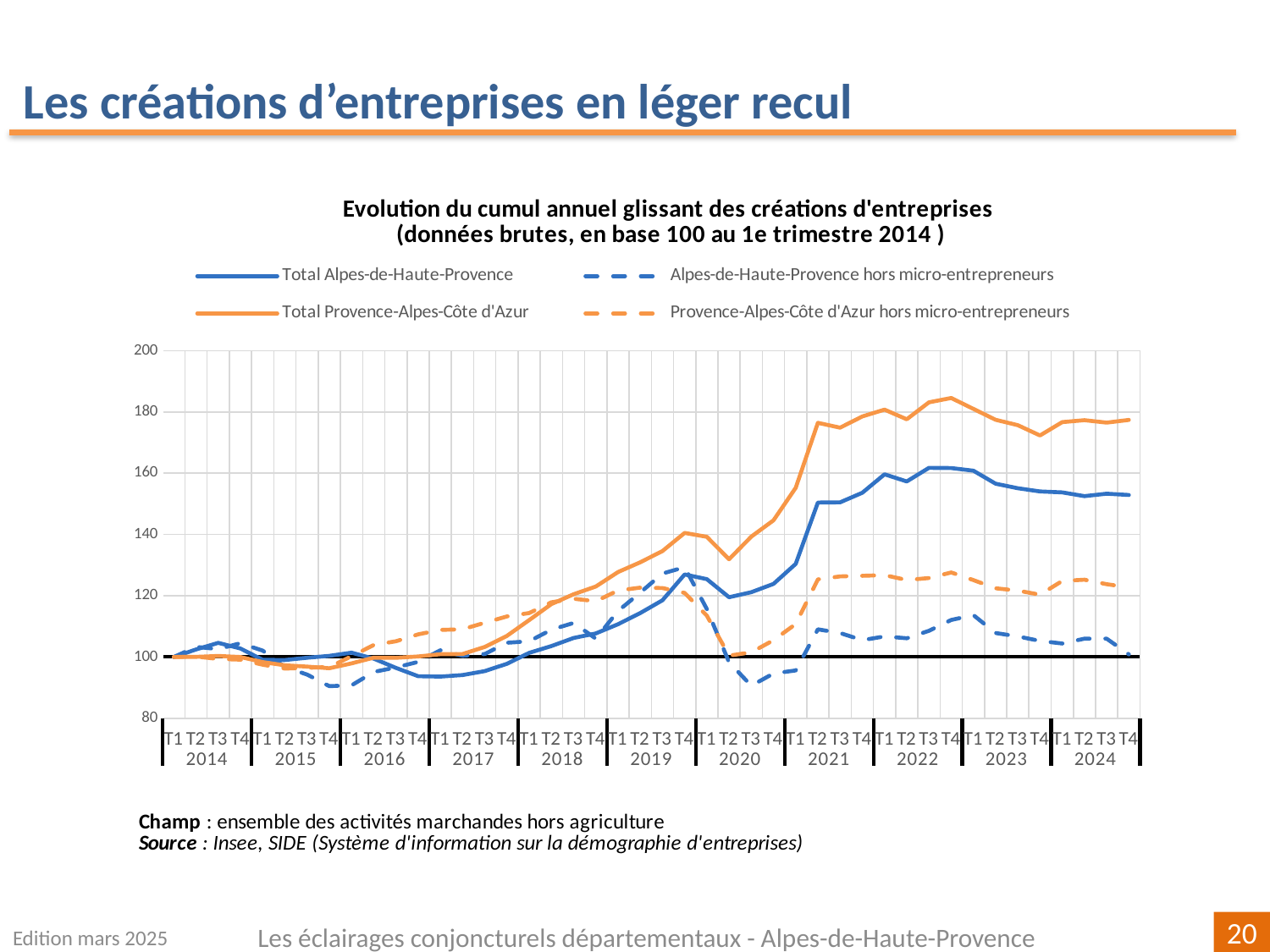
At T4 2024, which is higher: Total Provence-Alpes-Côte d'Azur or Total Alpes-de-Haute-Provence? Total Provence-Alpes-Côte d'Azur At T4 2024, which is higher: Provence-Alpes-Côte d'Azur hors micro-entrepreneurs or Alpes-de-Haute-Provence hors micro-entrepreneurs? Provence-Alpes-Côte d'Azur hors micro-entrepreneurs Which quarter is used as the base 100 for the index in the chart? 1e trimestre 2014 Is the value for Total Provence-Alpes-Côte d'Azur at T4 2024 greater or less than 160? greater Is the value for Alpes-de-Haute-Provence hors micro-entrepreneurs at T3 2020 greater or less than 100? less How many series does the legend list? 4 How many years are labelled along the x axis? 11 Is the value for Total Alpes-de-Haute-Provence at T4 2024 greater or less than 140? greater Does the Total Provence-Alpes-Côte d'Azur series rise or fall overall from T1 2014 to T4 2024? rise What kind of chart is shown on the slide? line chart Does the Total Alpes-de-Haute-Provence series rise or fall between T4 2022 and T4 2024? fall